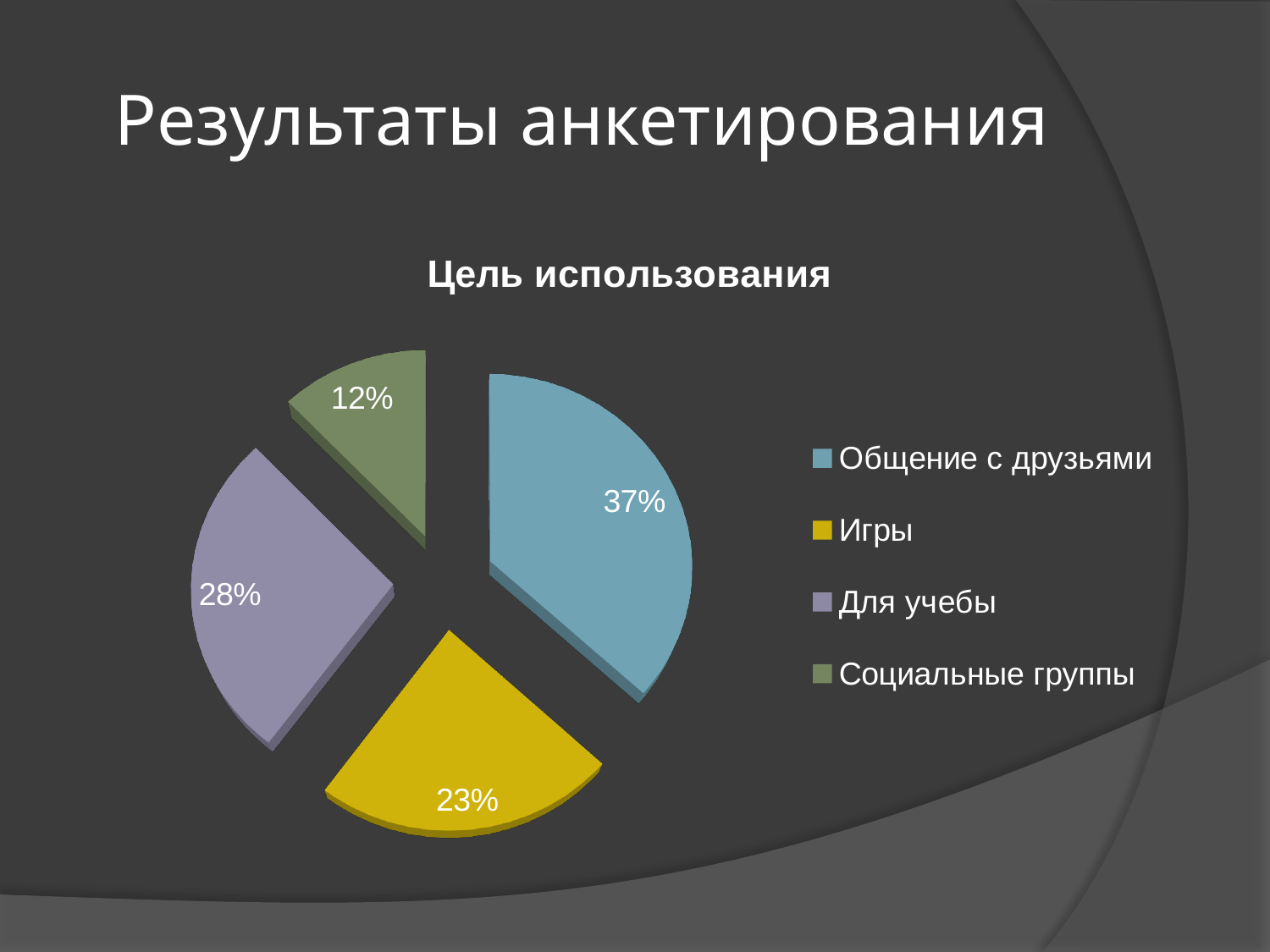
What is the value shown for "Социальные группы"? 12% What share of the pie does "Общение с друзьями" have? 37% What is the value shown for "Игры"? 23% What is the value shown for "Для учебы"? 28% How many categories are shown in the pie chart? 4 What is the title of the chart? Цель использования What kind of chart is shown on the slide? Pie chart Which category has the largest slice of the pie? Общение с друзьями Which category has the smallest slice of the pie? Социальные группы What is the difference between the values for "Для учебы" and "Социальные группы"? 16% What is the difference between the values for "Общение с друзьями" and "Игры"? 14% Which is larger, the value for "Для учебы" or the value for "Игры"? Для учебы